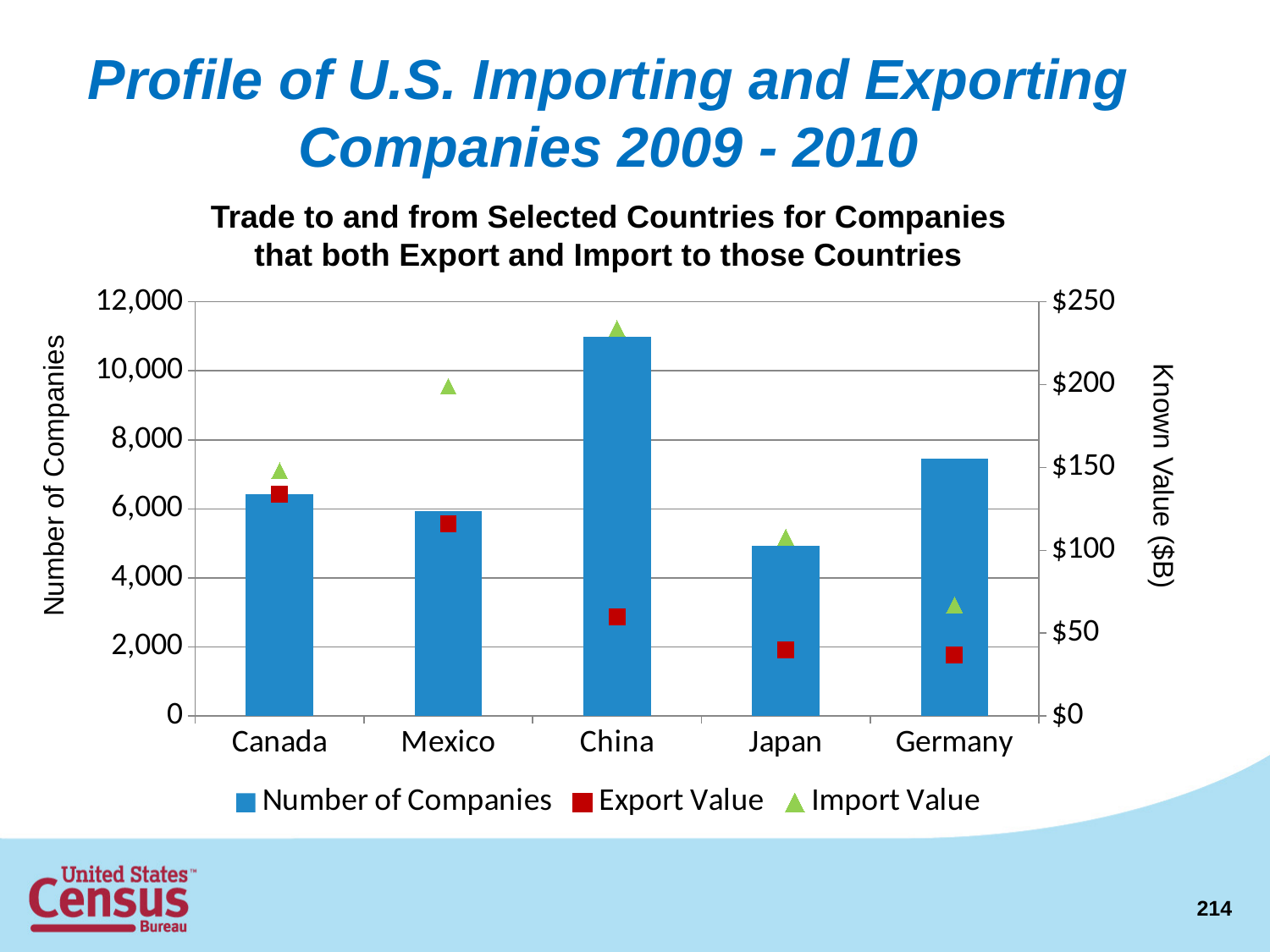
Is the Import Value for Mexico greater or less than $150? greater Which country has the highest Number of Companies? China How many countries are shown on the x axis of the chart? 5 Which has a larger Number of Companies, Germany or Canada? Germany What kind of chart is shown on the slide? combination bar and line chart (bars with markers) Which country has the lowest Number of Companies? Japan What is the label of the right-hand vertical axis? Known Value ($B) Is the Number of Companies for Japan greater or less than 6,000? less Is the Number of Companies for China greater or less than 10,000? greater Which country has the highest Export Value? Canada How many series does the chart legend list? 3 Which country has the highest Import Value? China